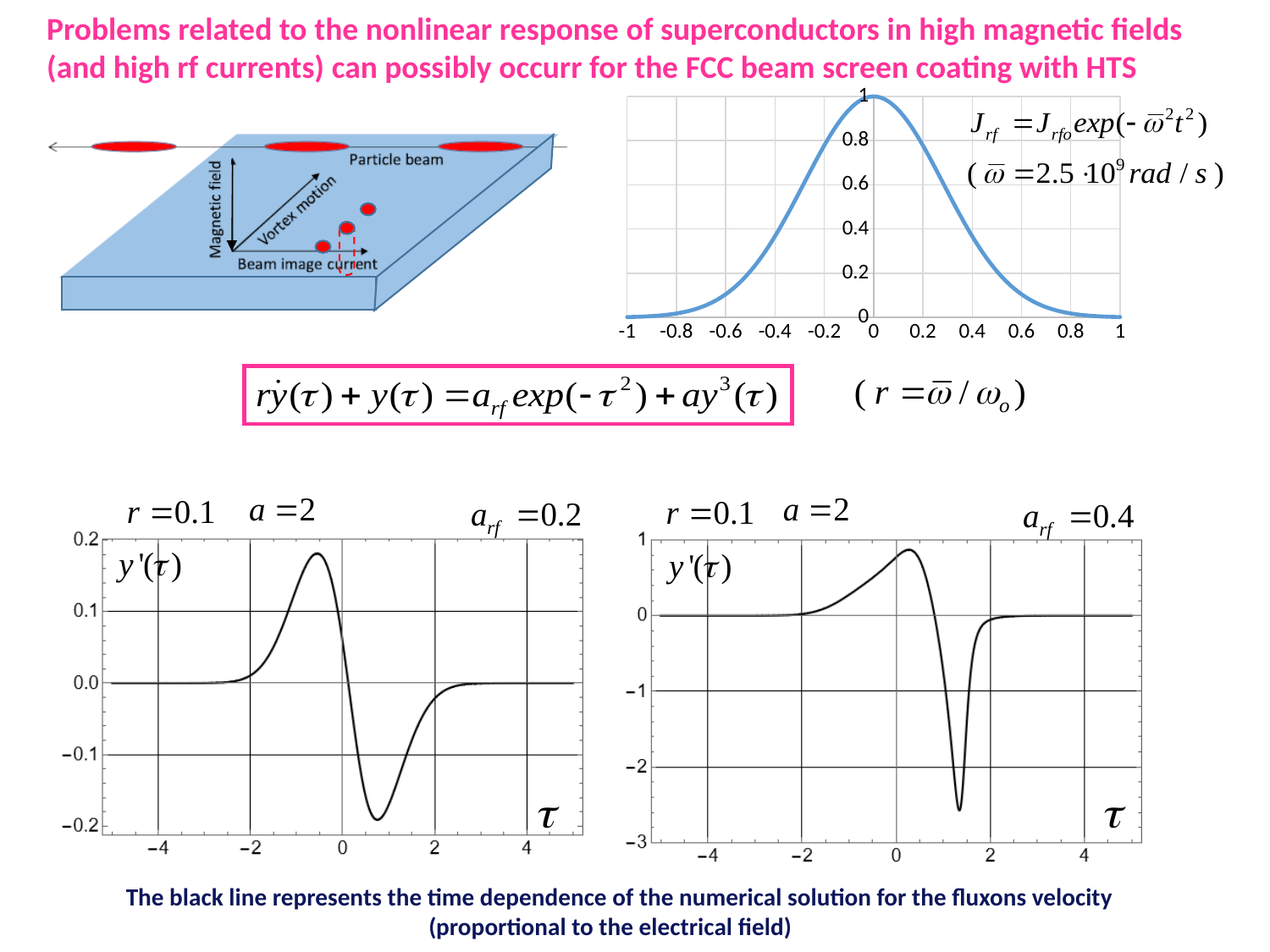
In the top-right chart, how many tick labels are shown on the x axis? 11 Which of the two bottom charts has the larger value of a_rf, the left or the right? the right In the bottom-right chart (a_rf = 0.4), is the maximum of the curve greater or less than 1? less In the top-right chart, does the curve rise or fall as x goes from 0 to 1? fall What kind of chart is the bottom-left chart of y'(τ)? line chart In the bottom-right chart (a_rf = 0.4), is the minimum of the curve greater or less than -2? less What kind of chart is the top-right chart showing J_rf? line chart In the bottom-left chart (a_rf = 0.2), is the maximum of the curve greater or less than 0.1? greater In the top-right chart, what is the value of the curve at x = 0? 1